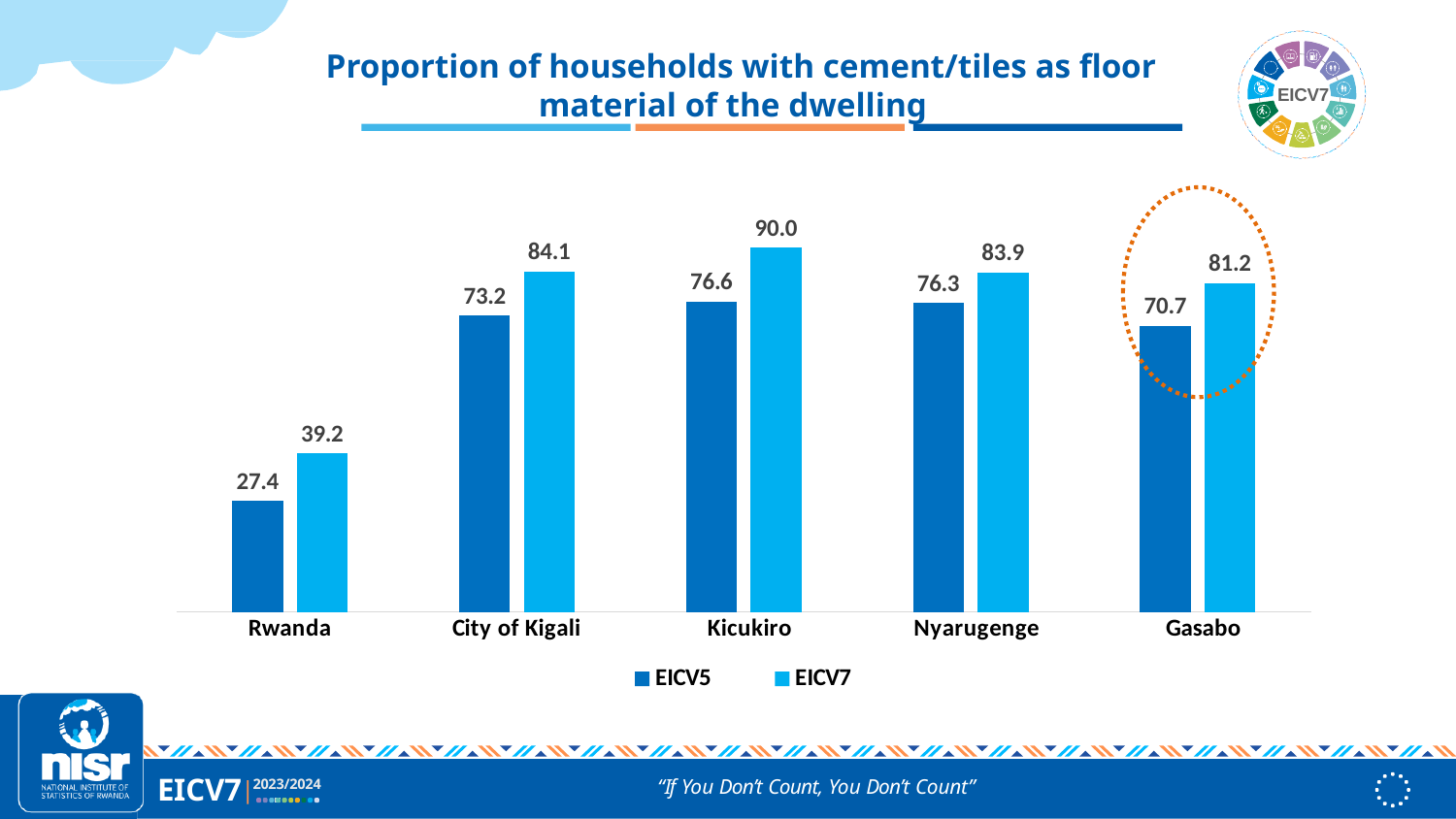
Which category has the lowest EICV5 value? Rwanda How many series does the legend list? 2 Which category is highlighted with a dotted orange circle? Gasabo What is the EICV7 value for Kicukiro? 90.0 What is the EICV7 value for Gasabo? 81.2 What is the EICV5 value for Rwanda? 27.4 What kind of chart is shown on the slide? Bar chart Which is larger, the EICV5 value for Kicukiro or the EICV5 value for City of Kigali? Kicukiro What is the difference between the EICV7 and EICV5 values for Rwanda? 11.8 Which category has the highest EICV7 value? Kicukiro How many categories are shown on the x axis? 5 What is the difference between the EICV7 and EICV5 values for Gasabo? 10.5